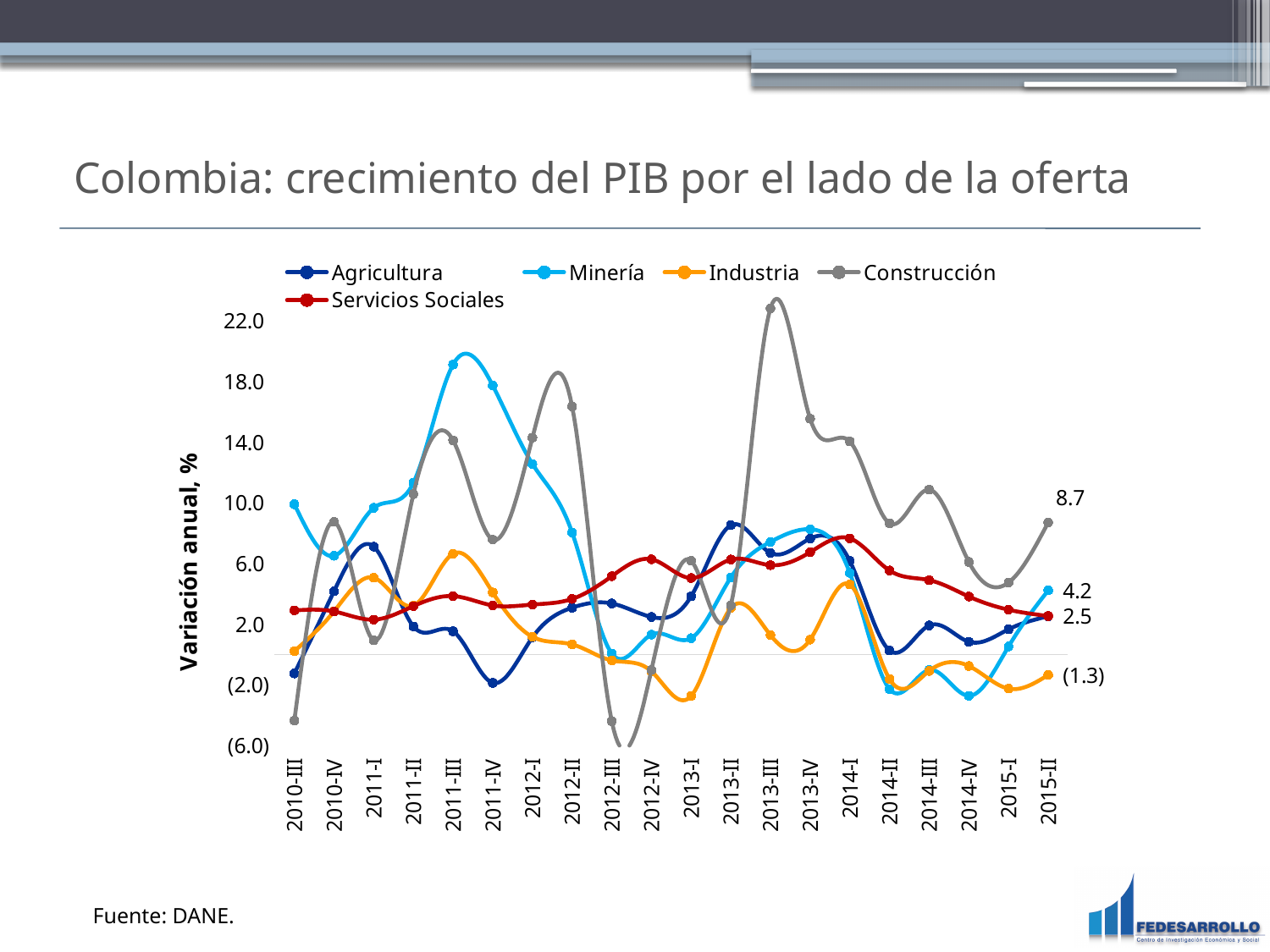
What kind of chart is shown on the slide? Line chart What is the value for Industria in 2015-II? (1.3) What is the value for Servicios Sociales in 2015-II? 2.5 Is the value for Construcción in 2012-III greater or less than (2.0)? less How many series does the legend list? 5 Which series has the lowest value in 2015-II? Industria Which series has the highest value in 2015-II? Construcción What is the difference between the Construcción and Minería values in 2015-II? 4.5 What is the value for Construcción in 2015-II? 8.7 What is the title of the vertical axis? Variación anual, % Is the value for Minería in 2011-III greater or less than 18.0? greater What is the value for Minería in 2015-II? 4.2